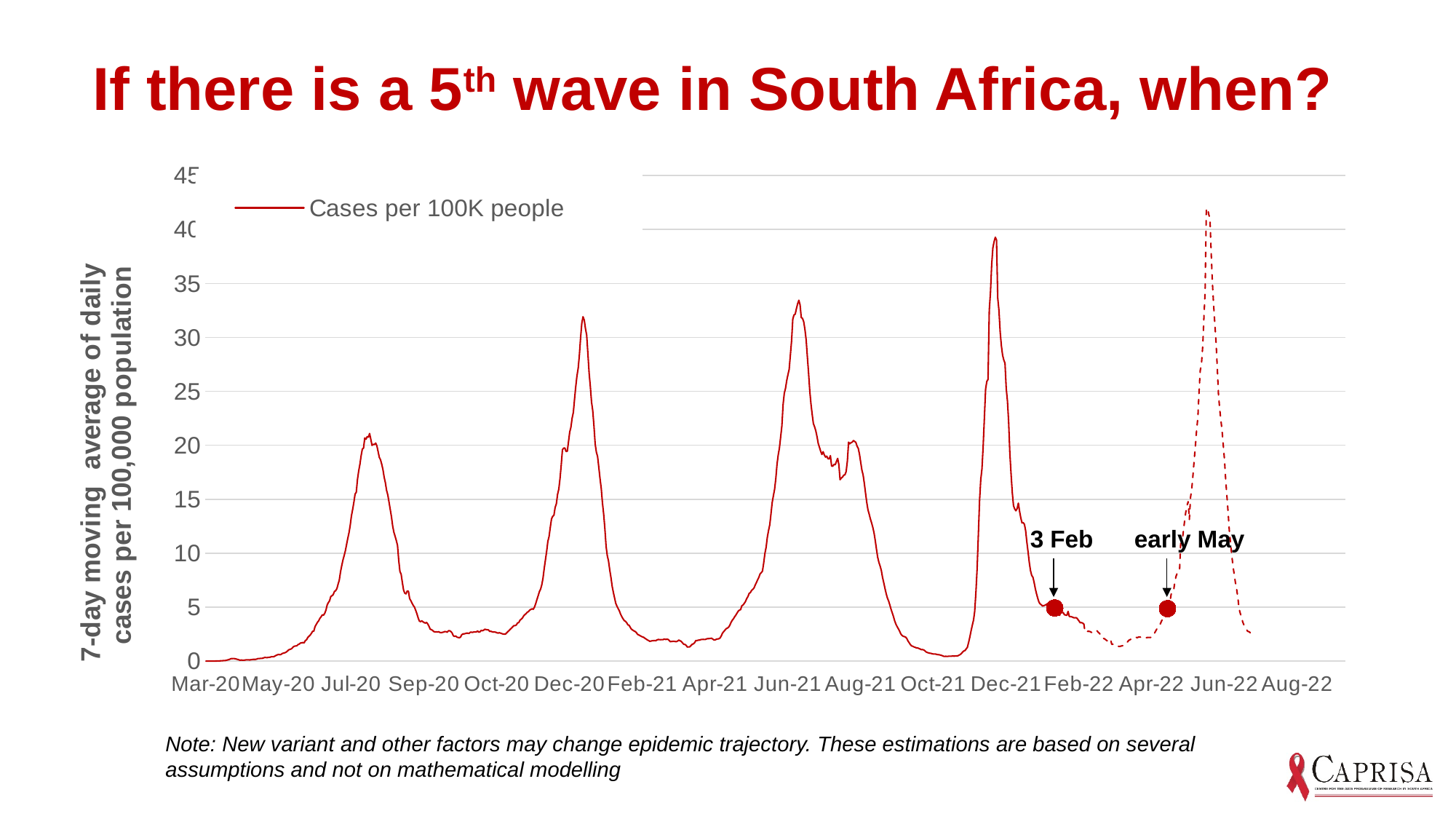
Is the value at the point marked '3 Feb' greater or less than 10? less Is the peak of the wave around Dec-20 greater or less than 30? greater What is the label on the vertical axis? 7-day moving average of daily cases per 100,000 population Does the line rise or fall between the Dec-21 peak and the point marked '3 Feb'? fall What kind of chart is shown on the slide? line chart Among the four solid-line waves, which has the lowest peak? the wave around Jul-20 Which of the solid-line waves has the highest peak: the one around Jul-20 or the one around Dec-21? Dec-21 Is the peak of the wave around Jul-20 greater or less than 25? less What is the series name shown in the legend? Cases per 100K people How many series does the legend list? 1